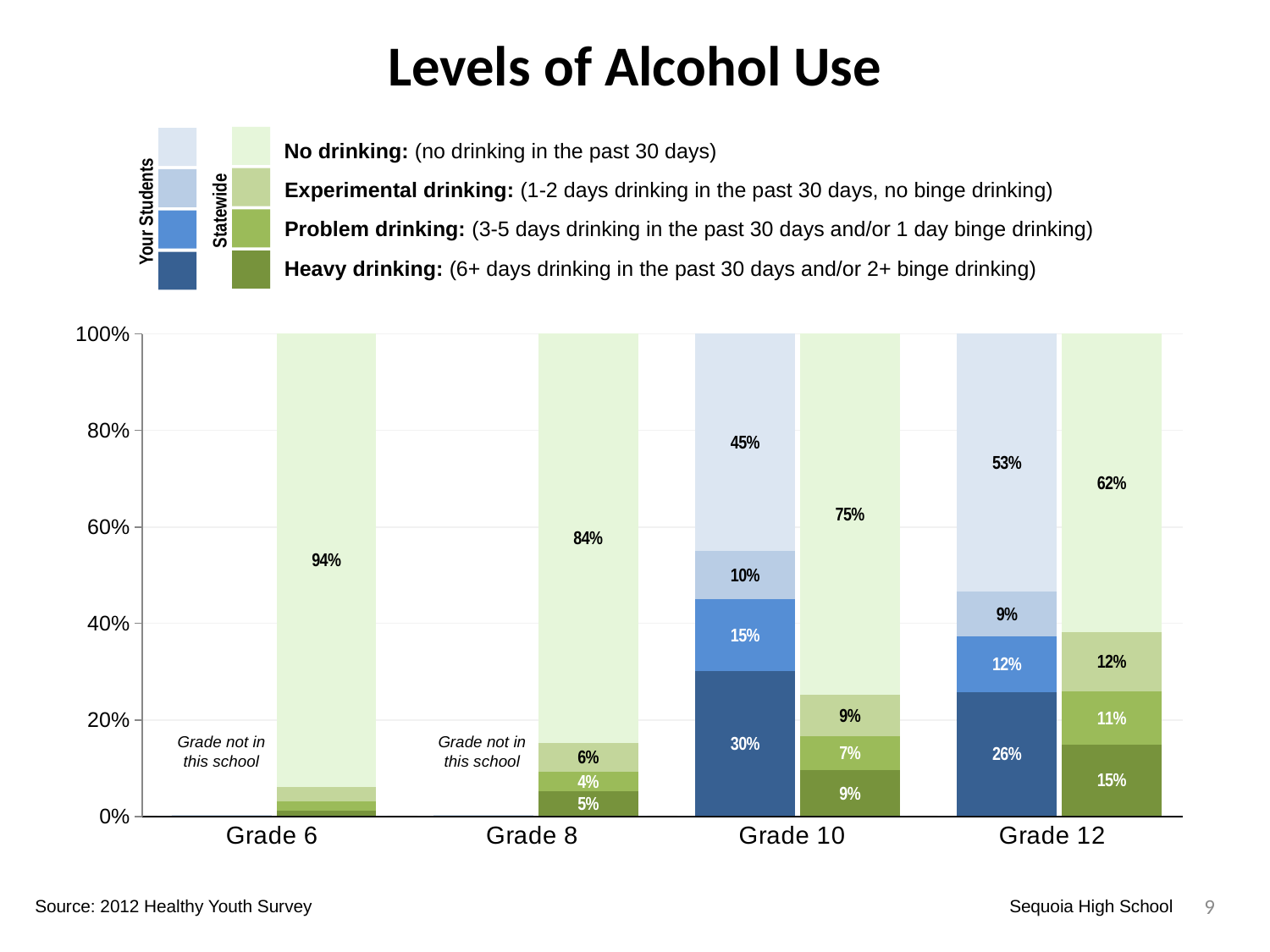
Which is larger: the heavy drinking percentage for Grade 12 at this school or statewide? This school (Your Students) How many grade levels are shown on the x axis? 4 What is the statewide percentage of Grade 8 students with no drinking in the past 30 days? 84% What percentage of Grade 10 students at this school fall into the heavy drinking category? 30% Does the statewide no drinking percentage rise or fall from Grade 6 to Grade 12? Fall Which grade has the highest statewide no drinking percentage? Grade 6 Is the statewide no drinking percentage for Grade 12 greater or less than 60%? greater What is the difference between the no drinking percentage for Grade 10 statewide and Grade 10 at this school? 30% What kind of chart is shown on the slide? Stacked bar chart What is the statewide heavy drinking percentage for Grade 12? 15% What percentage of Grade 12 students at this school are in the no drinking category? 53% Which grades are marked as 'Grade not in this school'? Grade 6 and Grade 8